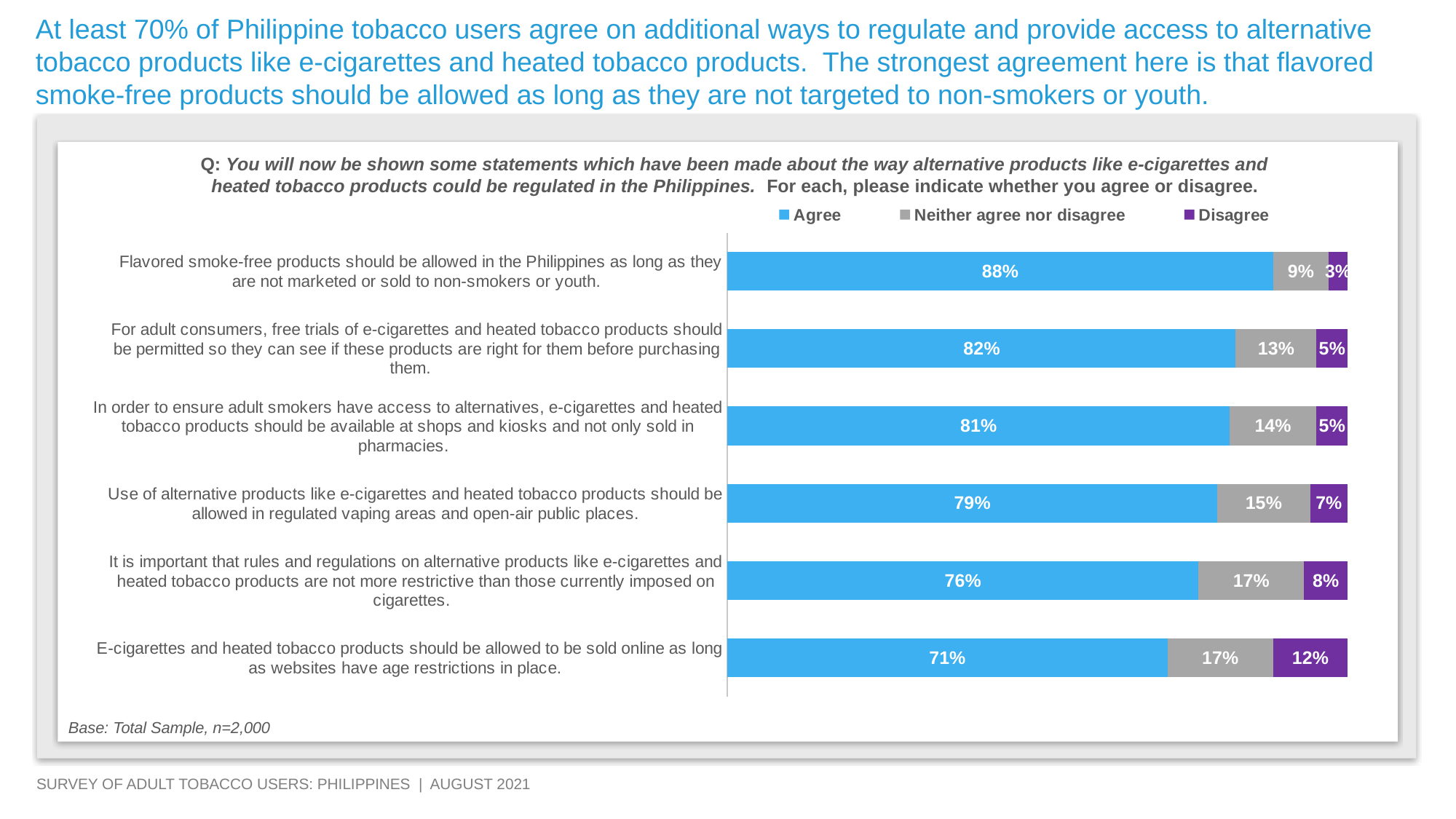
Which statement has the lowest Agree percentage? E-cigarettes and heated tobacco products should be allowed to be sold online as long as websites have age restrictions in place. What is the total of the Agree, Neither agree nor disagree and Disagree values for the statement about availability at shops and kiosks? 100% What percentage of respondents agree that flavored smoke-free products should be allowed in the Philippines as long as they are not marketed or sold to non-smokers or youth? 88% What percentage of respondents neither agree nor disagree that rules and regulations on alternative products should not be more restrictive than those currently imposed on cigarettes? 17% What percentage of respondents disagree that e-cigarettes and heated tobacco products should be allowed to be sold online as long as websites have age restrictions in place? 12% Which has a higher Disagree percentage: the statement about free trials for adult consumers or the statement about regulated vaping areas and open-air public places? The statement about regulated vaping areas and open-air public places How many series does the legend list? 3 What is the difference in Agree percentage between the statement about flavored smoke-free products and the statement about selling online with age restrictions? 17 percentage points How many statements are shown in the chart? 6 What is the base sample size noted below the chart? Total Sample, n=2,000 What kind of chart is shown on the slide? Stacked bar chart Which statement has the highest Agree percentage? Flavored smoke-free products should be allowed in the Philippines as long as they are not marketed or sold to non-smokers or youth.